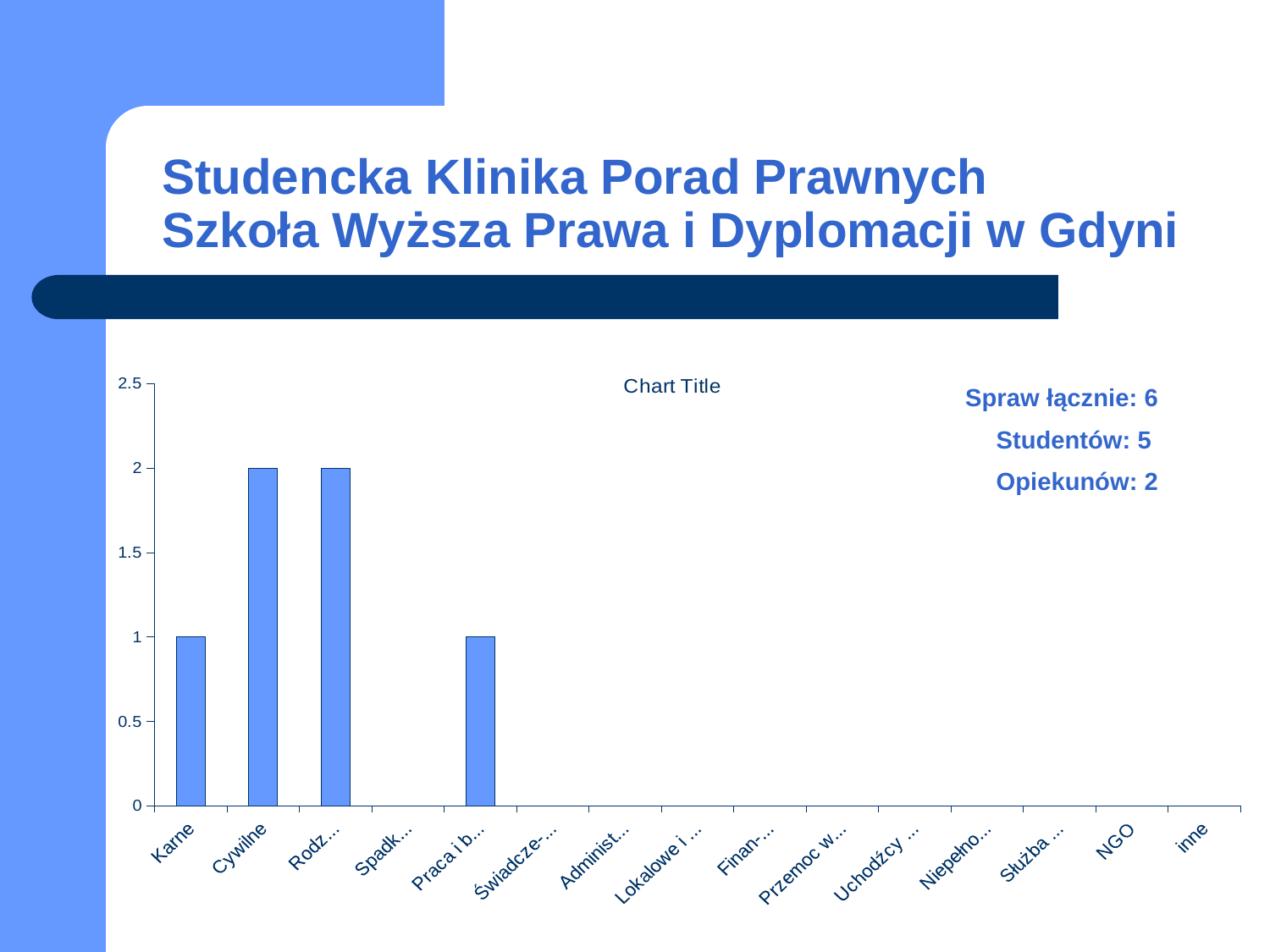
What is the value for Cywilne? 2 Is the value for Karne greater or less than 1.5? less What type of chart is shown on the slide? bar chart What is the value for NGO? 0 What is the highest value shown on the vertical axis of the chart? 2.5 What is the value for the category labelled "Praca i b..."? 1 Which is larger, the value for Cywilne or the value for Karne? Cywilne What is the value for Karne? 1 Is the value for Cywilne greater or less than 1.5? greater What is the title shown on the chart? Chart Title How many categories are shown on the x axis of the chart? 15 What is the difference between the value for Cywilne and the value for Karne? 1